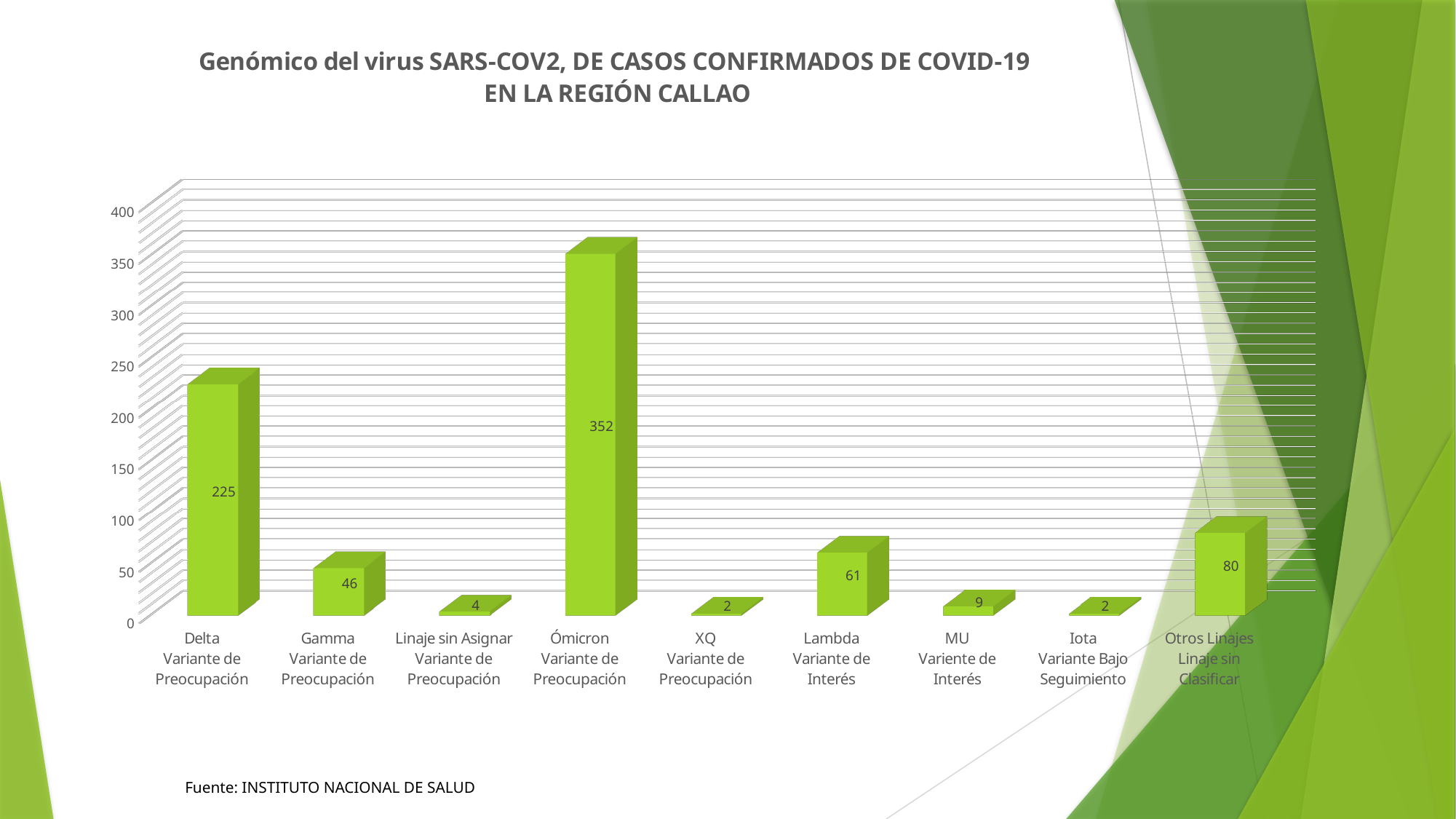
Which category has the highest value? Ómicron What is the value for Otros Linajes (Linaje sin Clasificar)? 80 Which is larger, the value for Gamma or the value for Lambda? Lambda What is the value for MU (Variente de Interés)? 9 What source is cited below the chart? INSTITUTO NACIONAL DE SALUD What is the value for Delta (Variante de Preocupación)? 225 What kind of chart is shown on the slide? bar chart Is the value for Delta greater or less than 200? greater What is the value for Ómicron (Variante de Preocupación)? 352 What is the difference between the values for Ómicron and Delta? 127 What is the value for Lambda (Variante de Interés)? 61 How many categories are shown on the x axis? 9